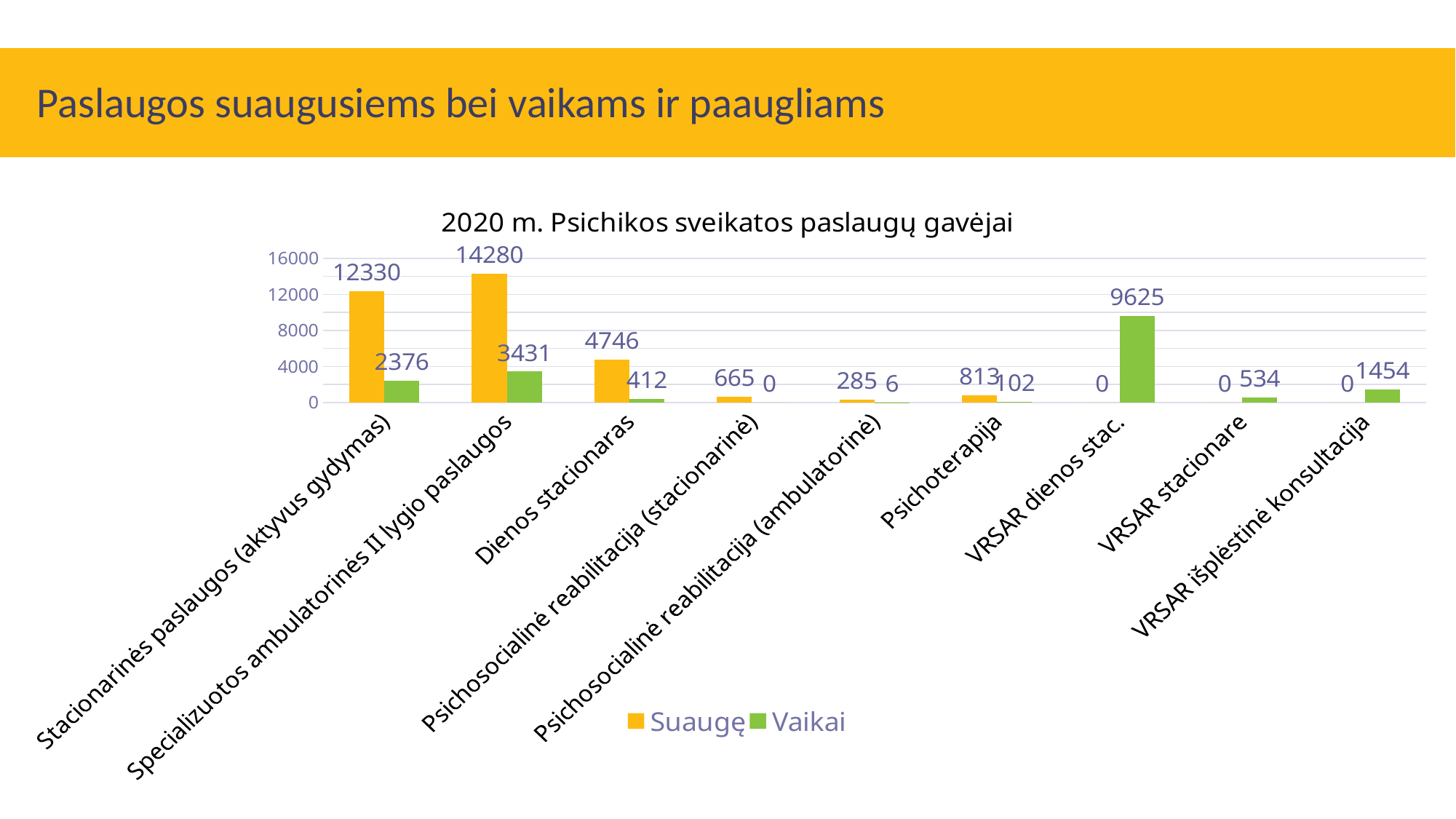
What kind of chart is shown on the slide? Bar chart What is the Vaikai value for VRSAR dienos stac.? 9625 Which category has the highest Vaikai value? VRSAR dienos stac. Which is larger: the Vaikai value for VRSAR išplėstinė konsultacija or the Vaikai value for VRSAR stacionare? VRSAR išplėstinė konsultacija How many categories are shown on the x axis? 9 Which category has the highest Suaugę value? Specializuotos ambulatorinės II lygio paslaugos How many series does the legend list? 2 What is the Suaugę value for Psichoterapija? 813 What is the difference between the Suaugę and Vaikai values for Stacionarinės paslaugos (aktyvus gydymas)? 9954 What is the Suaugę value for Specializuotos ambulatorinės II lygio paslaugos? 14280 What is the title of the chart? 2020 m. Psichikos sveikatos paslaugų gavėjai What is the Vaikai value for Dienos stacionaras? 412